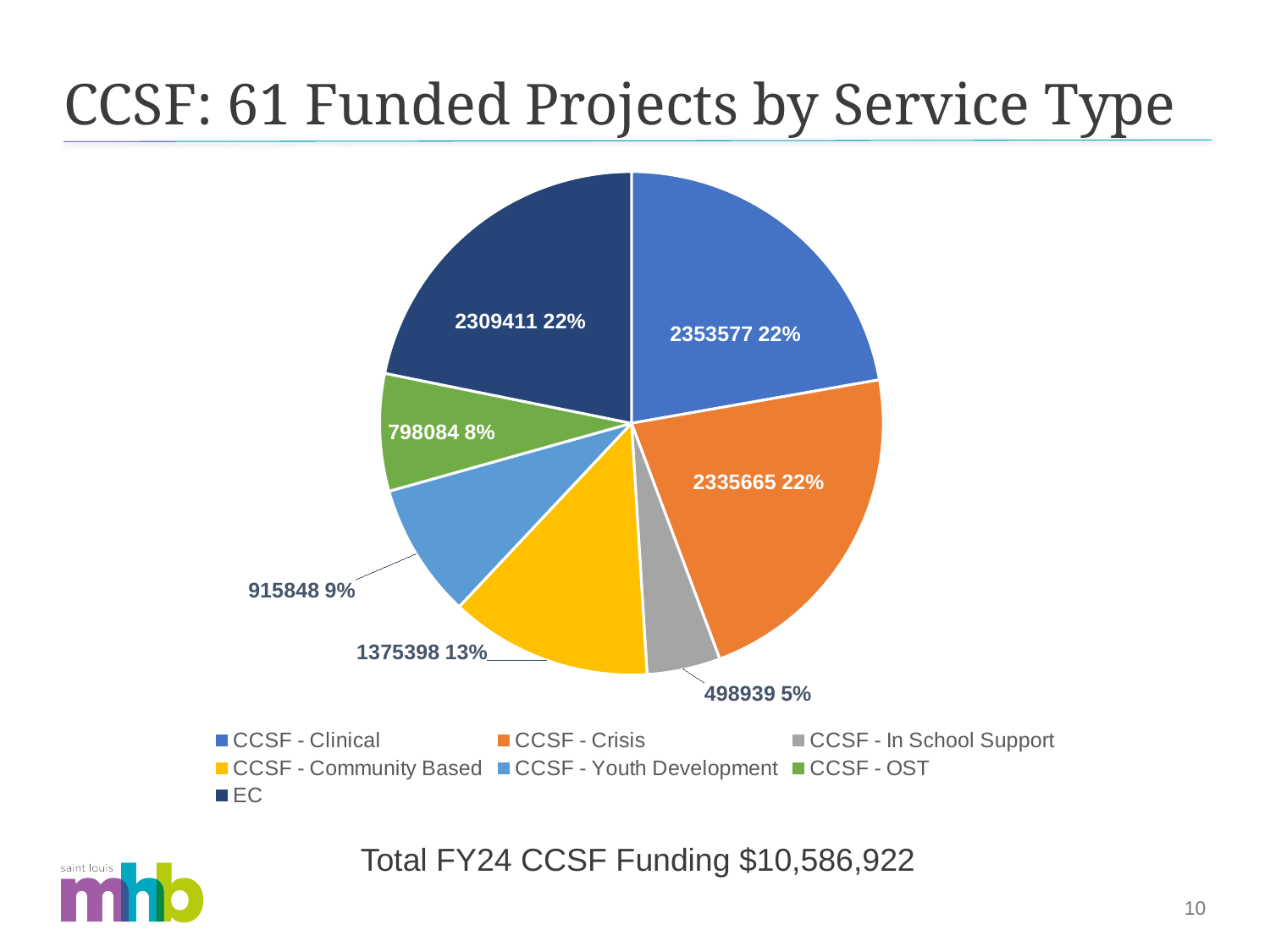
What is the value shown for CCSF - Community Based? 1375398 What share of the pie does CCSF - Community Based represent? 13% What share of the pie does CCSF - In School Support represent? 5% What is the value shown for EC? 2309411 What is the value shown for CCSF - Clinical? 2353577 Which service type has the smallest slice of the pie? CCSF - In School Support What is the difference between the values for CCSF - Community Based and CCSF - Youth Development? 459550 How many slices does the pie chart have? 7 What is the value shown for CCSF - Crisis? 2335665 Which is larger, the value for CCSF - Community Based or CCSF - Youth Development? CCSF - Community Based What is the title of the chart on the slide? CCSF: 61 Funded Projects by Service Type What kind of chart is shown on the slide? Pie chart